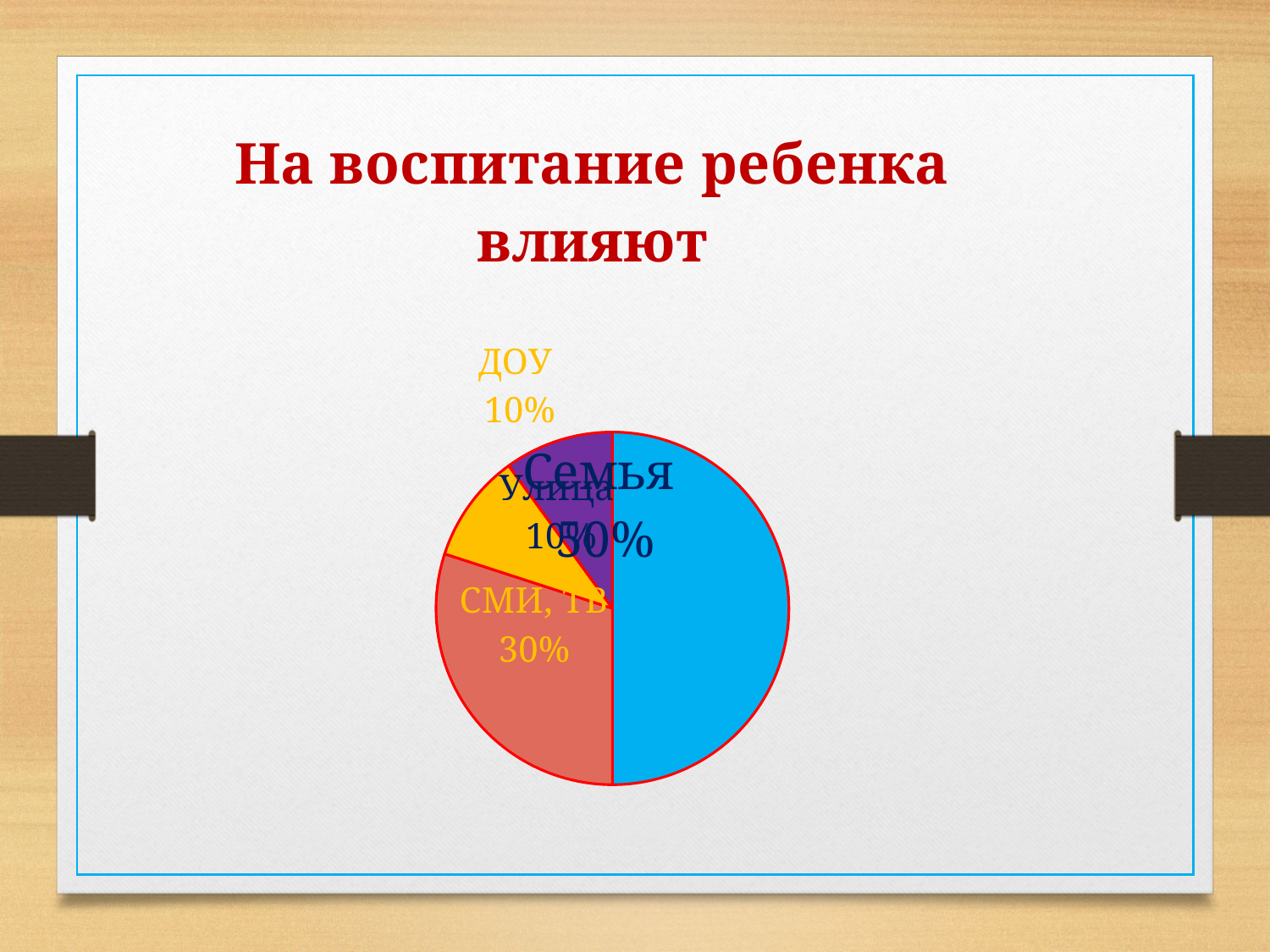
Which category has the largest slice of the pie? Семья Which is larger, the slice for СМИ, ТВ or the slice for ДОУ? СМИ, ТВ What kind of chart is shown on the slide? pie chart What share of the pie does СМИ, ТВ have? 30% What colour is the Семья slice of the pie? blue Which is larger, the slice for Семья or the slice for СМИ, ТВ? Семья What share of the pie does Семья have? 50% What is the difference in percentage points between the СМИ, ТВ slice and the ДОУ slice? 20% What is the title of the chart on the slide? На воспитание ребенка влияют What share of the pie does ДОУ have? 10% What is the difference in percentage points between the Семья slice and the СМИ, ТВ slice? 20% How many slices does the pie chart have? 4